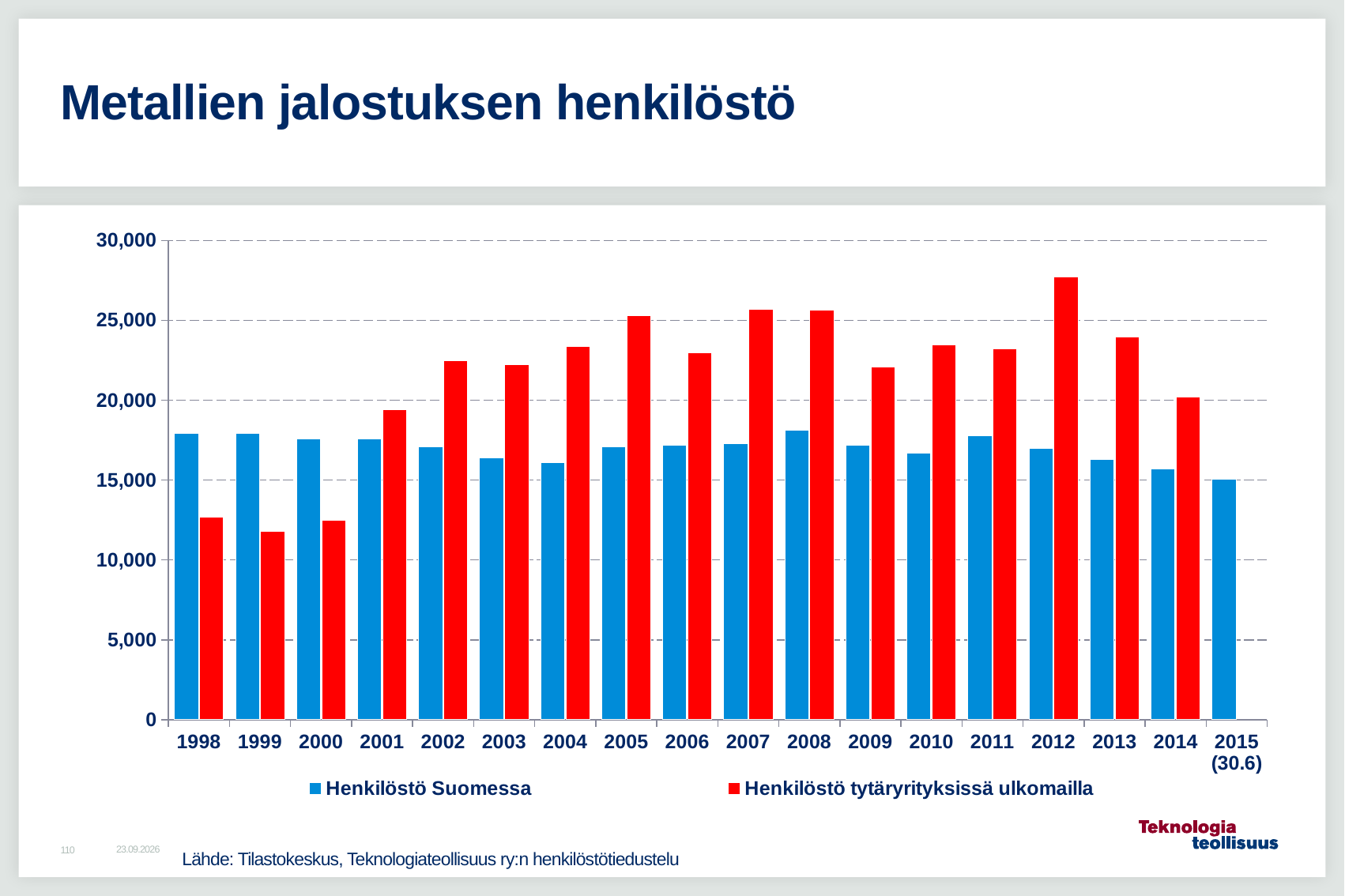
Is the value for Henkilöstö tytäryrityksissä ulkomailla in 2012 greater or less than 25,000? greater In which year is the value for Henkilöstö tytäryrityksissä ulkomailla lowest? 1999 In which year is the value for Henkilöstö tytäryrityksissä ulkomailla highest? 2012 In 1998, which is larger: Henkilöstö Suomessa or Henkilöstö tytäryrityksissä ulkomailla? Henkilöstö Suomessa In which year is the value for Henkilöstö Suomessa lowest? 2015 (30.6) Is the value for Henkilöstö tytäryrityksissä ulkomailla in 1999 greater or less than 15,000? less Is the value for Henkilöstö tytäryrityksissä ulkomailla in 2009 greater or less than 20,000? greater Which colour represents Henkilöstö Suomessa in the chart? blue What kind of chart is shown on the slide? bar chart In 2012, which is larger: Henkilöstö Suomessa or Henkilöstö tytäryrityksissä ulkomailla? Henkilöstö tytäryrityksissä ulkomailla How many series does the legend list? 2 How many years (categories) are shown on the x axis? 18